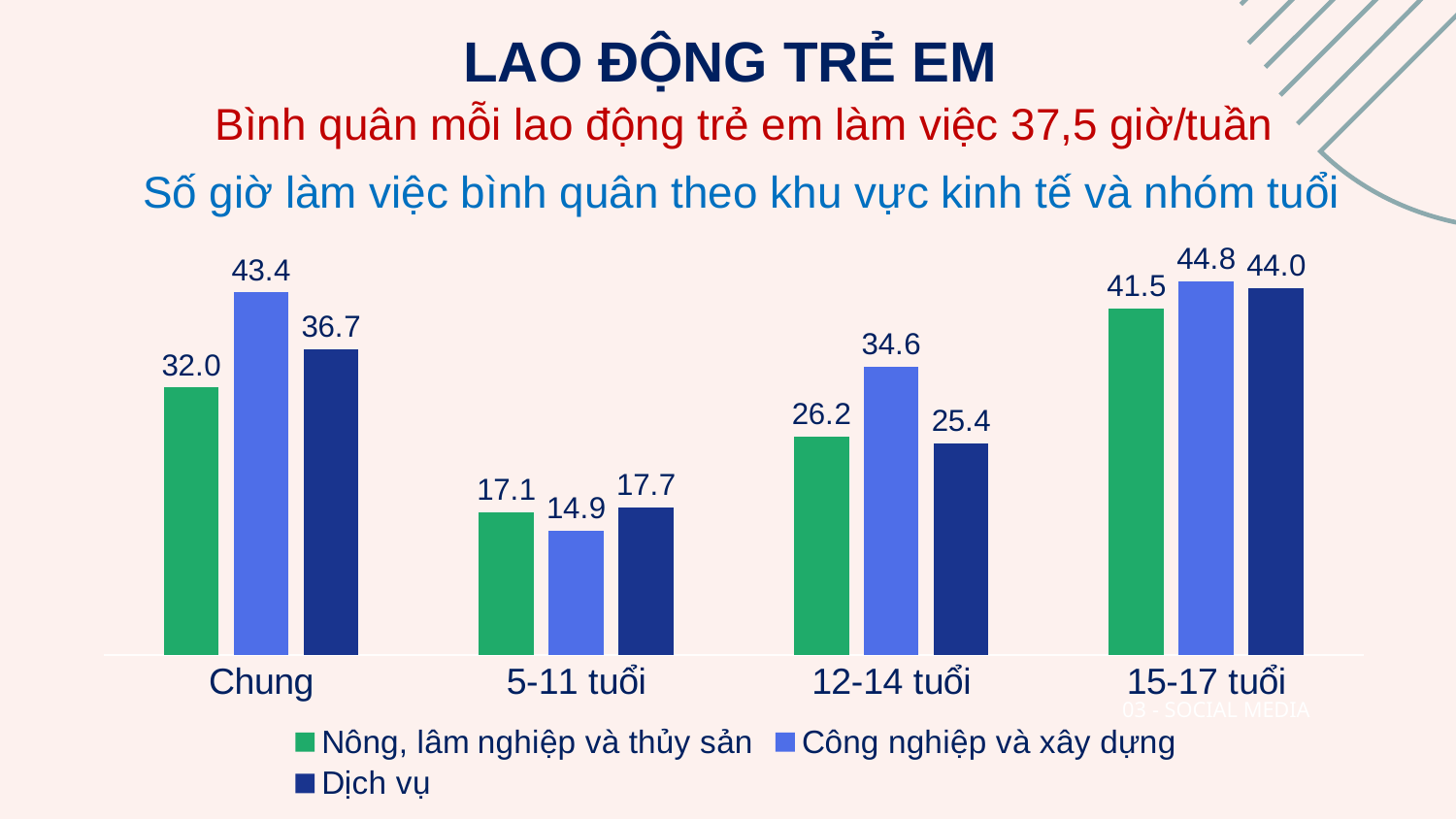
Which category has the highest value for Dịch vụ? 15-17 tuổi How many series does the legend list? 3 What is the title of the chart? Số giờ làm việc bình quân theo khu vực kinh tế và nhóm tuổi In the 12-14 tuổi category, which is larger: Nông, lâm nghiệp và thủy sản or Công nghiệp và xây dựng? Công nghiệp và xây dựng Which age group has the lowest value for Công nghiệp và xây dựng? 5-11 tuổi What is the value for Công nghiệp và xây dựng in the Chung category? 43.4 How many age-group categories are shown on the x axis? 4 What is the difference between the Công nghiệp và xây dựng value and the Nông, lâm nghiệp và thủy sản value in the Chung category? 11.4 What kind of chart is shown on the slide? Bar chart What is the value for Nông, lâm nghiệp và thủy sản in the 15-17 tuổi category? 41.5 What is the value for Dịch vụ in the 12-14 tuổi category? 25.4 Do the values for Dịch vụ rise or fall from 5-11 tuổi to 15-17 tuổi? Rise